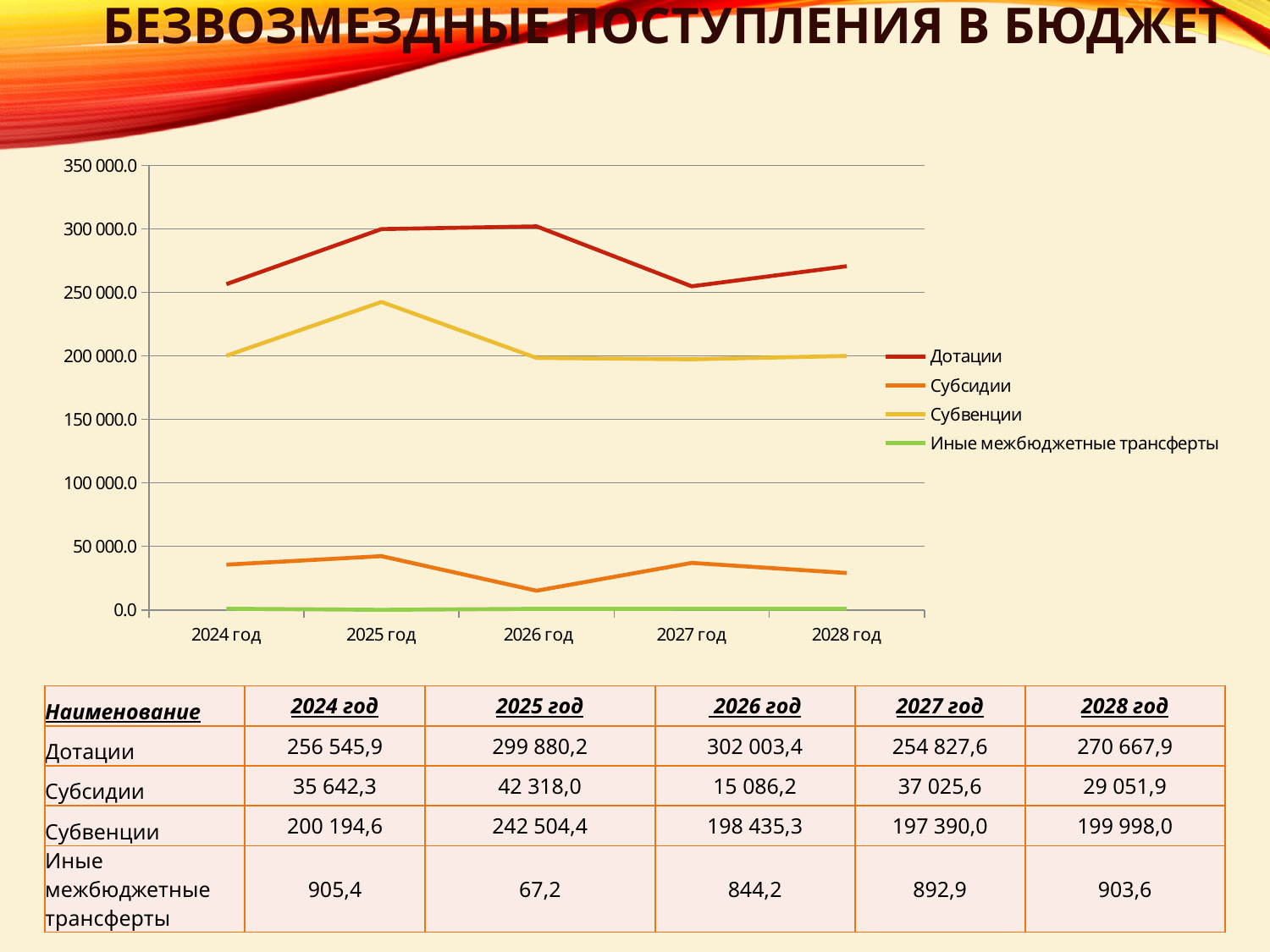
In which year is Субсидии lowest? 2026 год What is the value of Дотации for 2026 год? 302 003,4 Is the value of Дотации for 2024 год greater or less than 250 000.0? greater What is the difference between Субсидии in 2025 год and 2026 год? 27 231,8 How many years are shown on the x axis of the chart? 5 How many series does the chart legend list? 4 Which series has the highest values across all years? Дотации Which is larger in 2025 год: Субвенции or Субсидии? Субвенции What is the value of Субвенции for 2027 год? 197 390,0 What kind of chart is shown on the slide? line chart What is the value of Субсидии for 2025 год? 42 318,0 In which year is Дотации highest? 2026 год